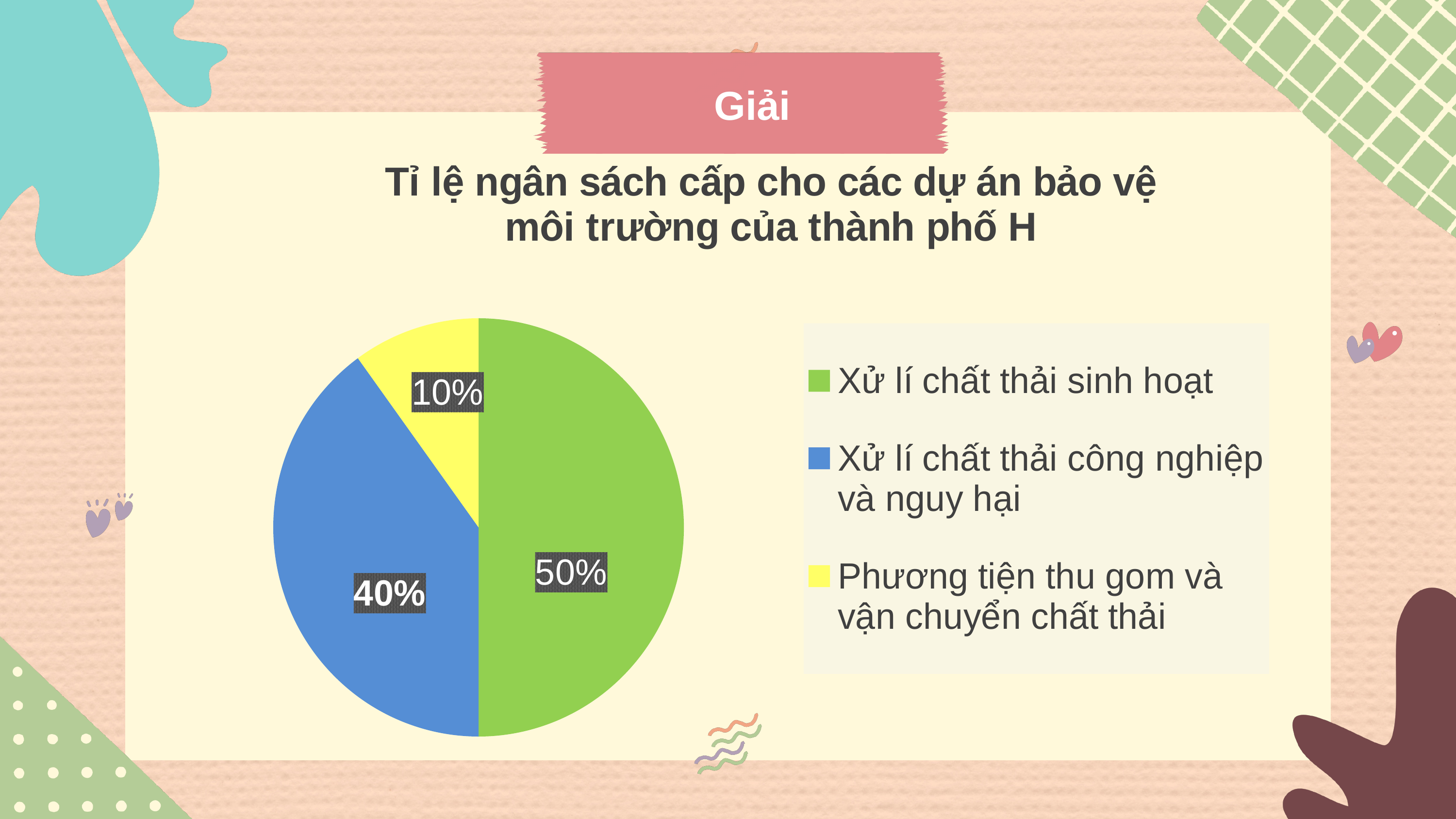
What colour is the slice for "Phương tiện thu gom và vận chuyển chất thải"? Yellow What is the title of the chart? Tỉ lệ ngân sách cấp cho các dự án bảo vệ môi trường của thành phố H How many slices does the pie chart have? 3 What is the difference in percentage points between "Xử lí chất thải công nghiệp và nguy hại" and "Phương tiện thu gom và vận chuyển chất thải"? 30% Which is larger: the share for "Xử lí chất thải công nghiệp và nguy hại" or the share for "Phương tiện thu gom và vận chuyển chất thải"? Xử lí chất thải công nghiệp và nguy hại What is the difference in percentage points between "Xử lí chất thải sinh hoạt" and "Xử lí chất thải công nghiệp và nguy hại"? 10% What share of the budget goes to "Phương tiện thu gom và vận chuyển chất thải"? 10% What share of the budget goes to "Xử lí chất thải sinh hoạt"? 50% What kind of chart is shown on the slide? Pie chart What share of the budget goes to "Xử lí chất thải công nghiệp và nguy hại"? 40% Which category receives the largest share of the budget? Xử lí chất thải sinh hoạt Which category receives the smallest share of the budget? Phương tiện thu gom và vận chuyển chất thải